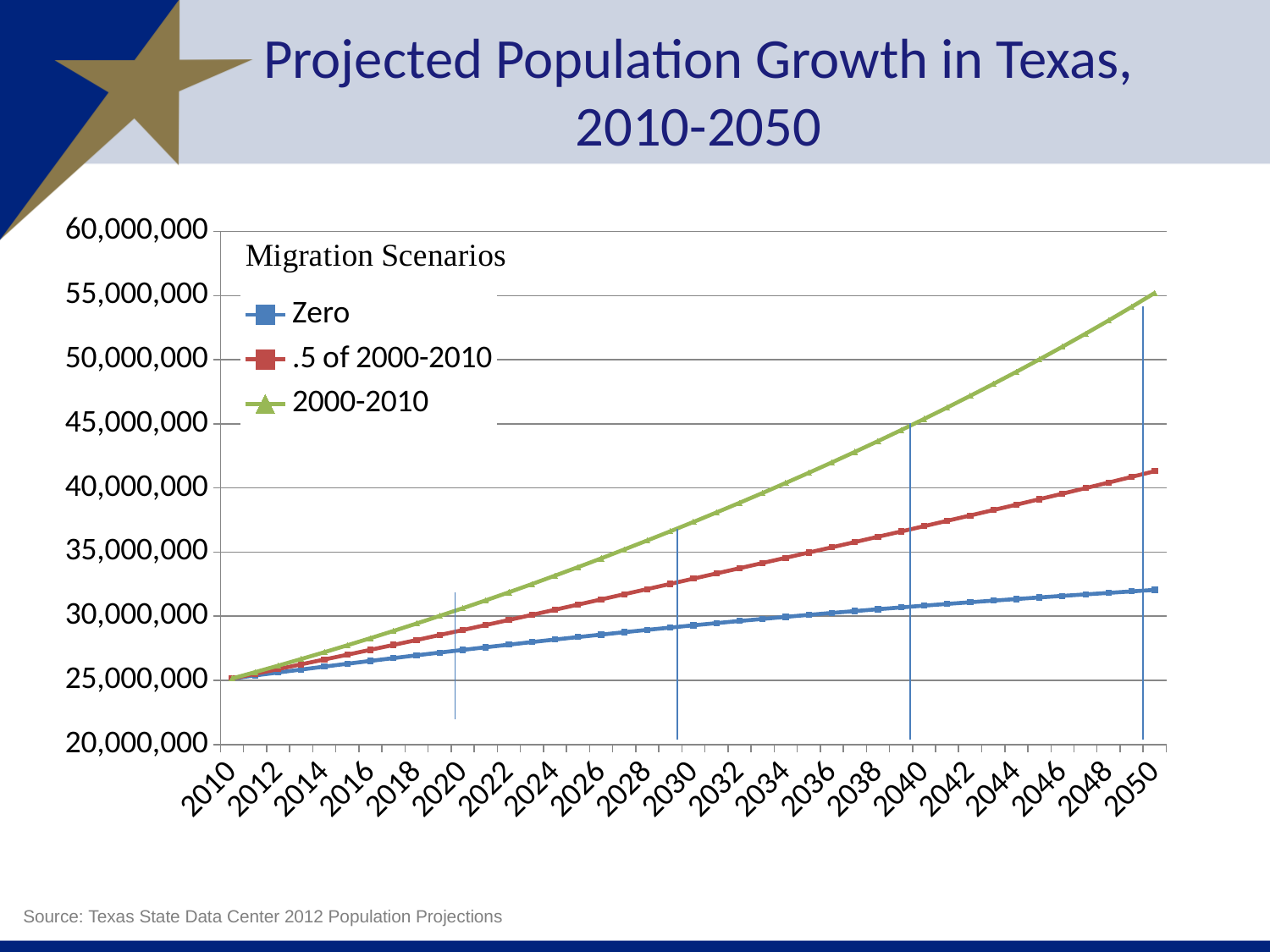
Is the value for the 2000-2010 scenario in 2030 greater or less than 35,000,000? greater What is the title of the chart? Projected Population Growth in Texas, 2010-2050 How many year labels are shown on the x axis? 21 Do the values for the 2000-2010 scenario rise or fall from 2010 to 2050? rise Is the value for the Zero scenario in 2030 greater or less than 30,000,000? less Is the value for the .5 of 2000-2010 scenario in 2040 greater or less than 35,000,000? greater Which migration scenario has the lowest projected population in 2050? Zero How many series does the legend list? 3 What kind of chart is shown on the slide? line chart What heading appears above the legend entries? Migration Scenarios Which migration scenario has the highest projected population in 2050? 2000-2010 In 2040, which is larger: the value for the .5 of 2000-2010 scenario or the Zero scenario? .5 of 2000-2010